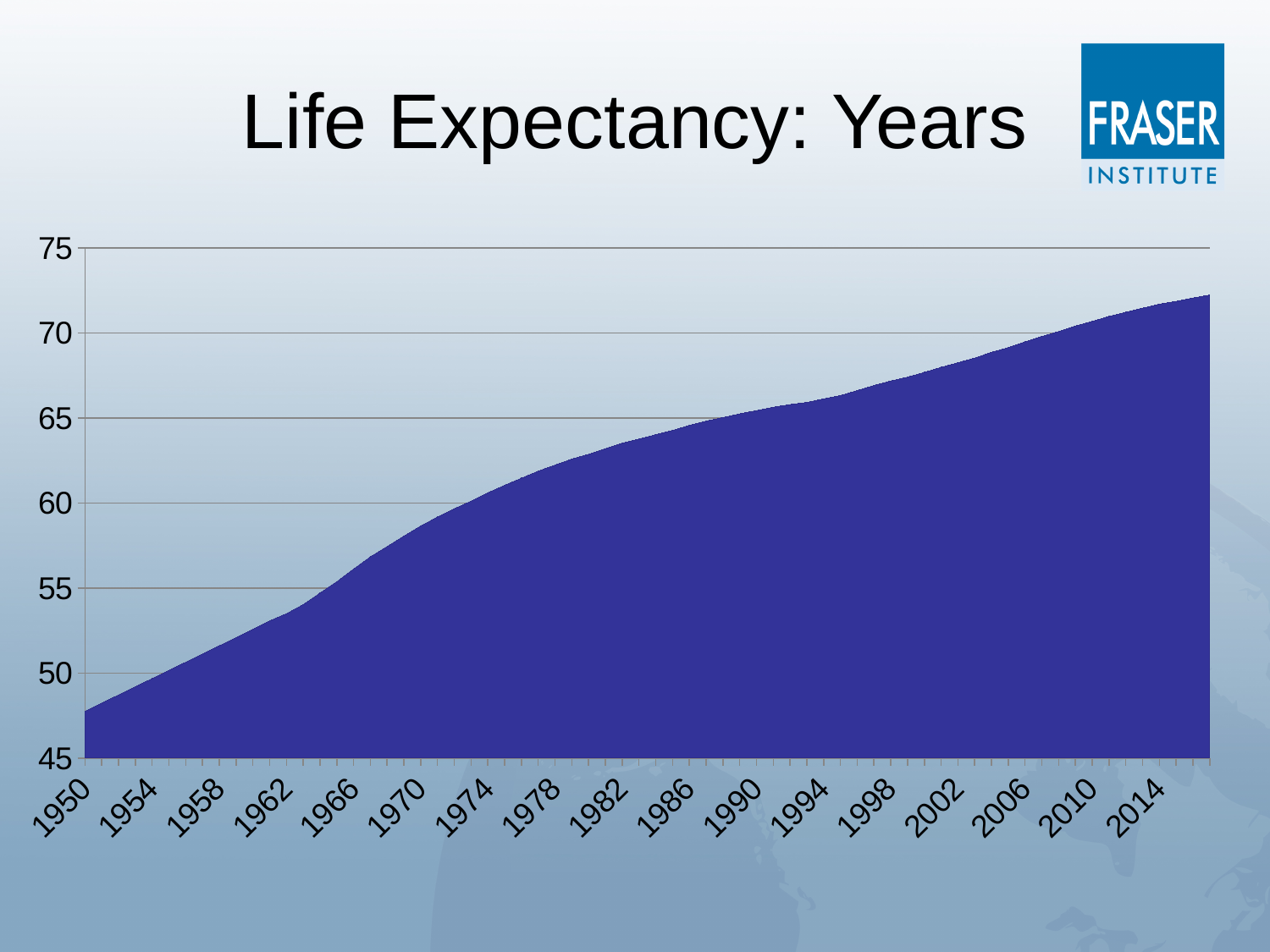
Is the value for 2002 greater or less than 70? less Is the value for 1978 greater or less than 60? greater Which year has the lowest life expectancy? 1950 Is the value for 1950 greater or less than 50? less What is the highest value shown on the vertical axis? 75 What is the title of the chart? Life Expectancy: Years What kind of chart is shown on the slide? area chart Which is larger, the value for 1966 or the value for 1986? 1986 Do the values rise or fall from 1950 to 2014? rise